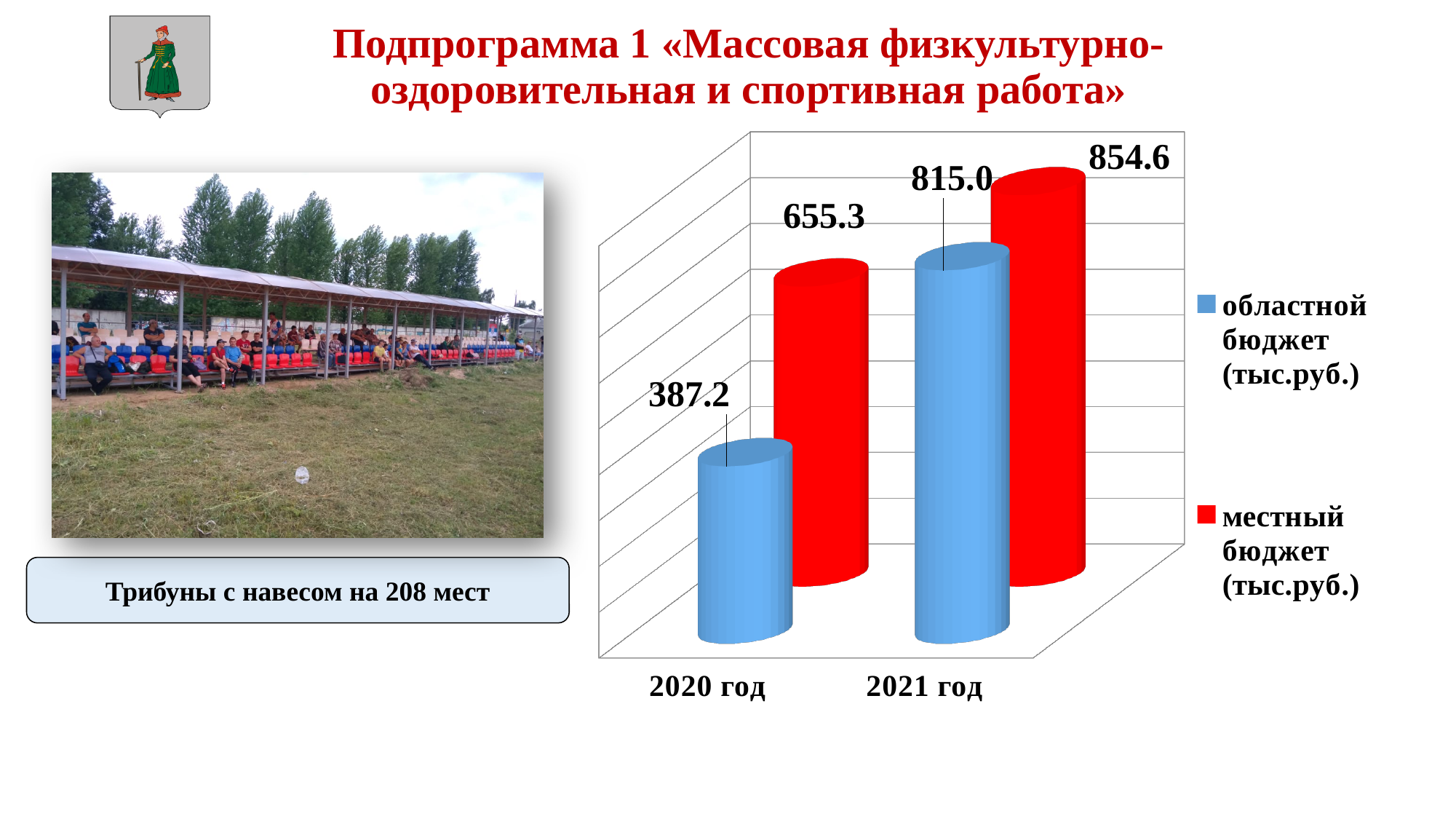
What is the value for местный бюджет in 2020 год? 655.3 Which year has the highest value for областной бюджет? 2021 год What is the difference between the местный бюджет values for 2021 год and 2020 год? 199.3 Which series has the lowest value in 2020 год? областной бюджет (тыс.руб.) What is the difference between the областной бюджет values for 2021 год and 2020 год? 427.8 What is the value for областной бюджет in 2020 год? 387.2 How many years are shown on the x axis of the chart? 2 What is the value for областной бюджет in 2021 год? 815.0 Which is larger in 2020 год: областной бюджет or местный бюджет? местный бюджет What is the value for местный бюджет in 2021 год? 854.6 How many series does the chart legend list? 2 Does the value for местный бюджет rise or fall from 2020 год to 2021 год? rise